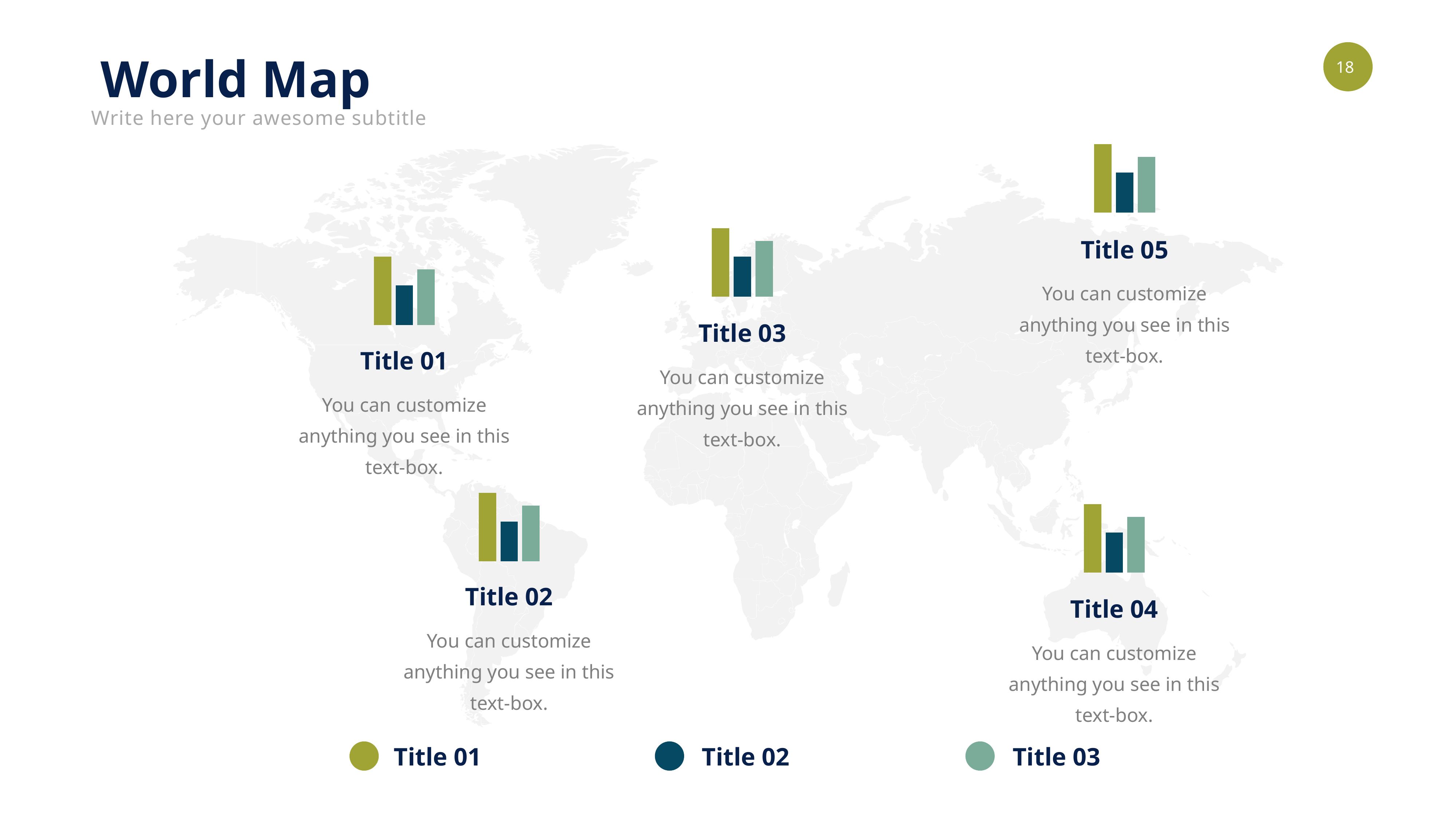
In the chart labelled Title 01, which legend series has the tallest bar? Title 01 What kind of chart is shown under the label Title 01 on the map? bar chart How many bars does the chart labelled Title 03 contain? 3 How many small bar charts are placed on the world map? 5 In the chart labelled Title 05, is the bar for the series Title 03 taller or shorter than the bar for the series Title 02? taller In the chart labelled Title 05, which legend series has the shortest bar? Title 02 What colour does the legend assign to the series Title 02? dark teal In the chart labelled Title 02, which legend series has the tallest bar? Title 01 In the chart labelled Title 01, which legend series has the shortest bar? Title 02 How many series does the legend at the bottom of the slide list? 3 In the chart labelled Title 04, which legend series has the tallest bar? Title 01 In the chart labelled Title 03, which legend series has the shortest bar? Title 02